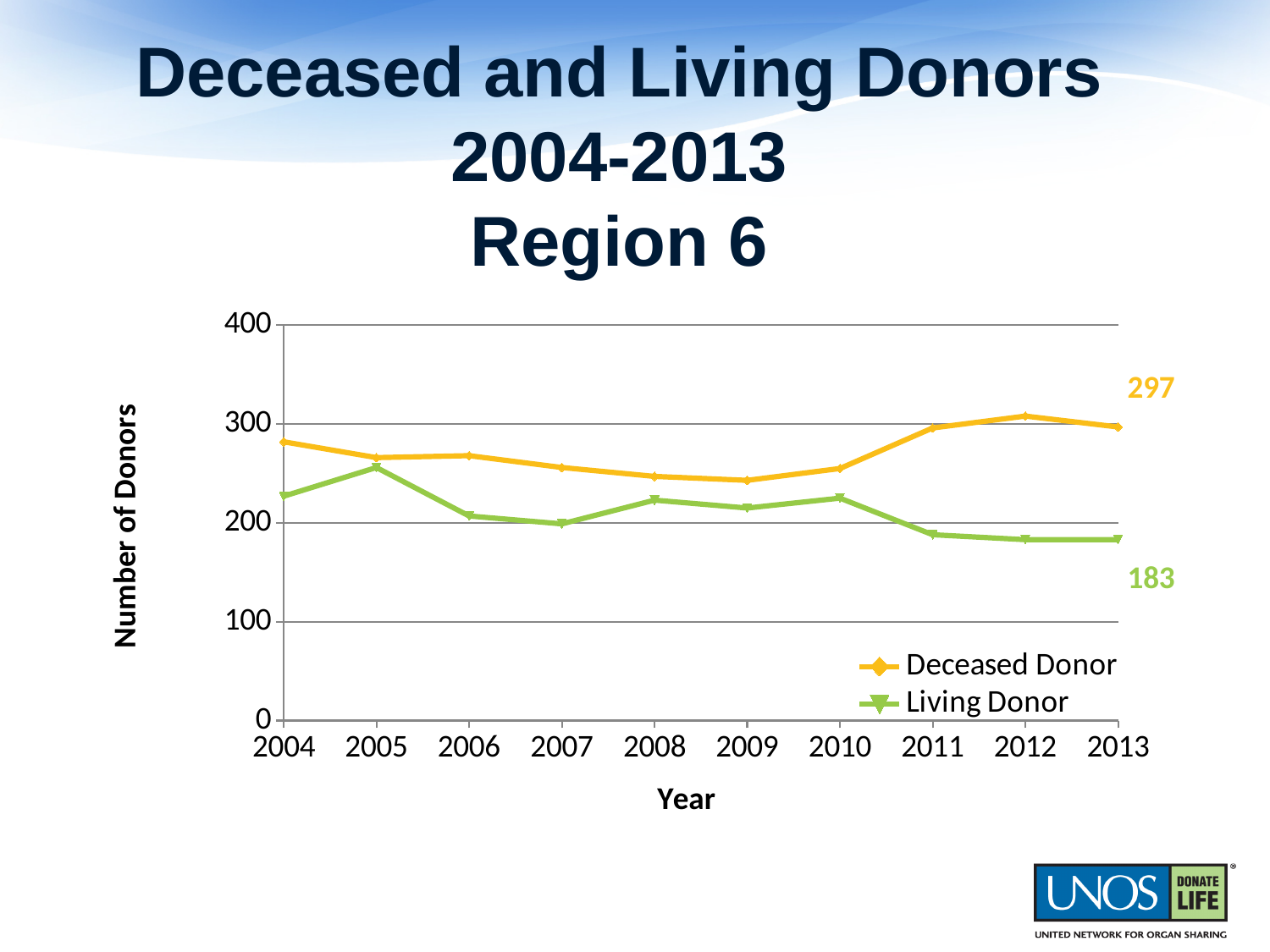
What kind of chart is shown on the slide? Line chart How many years are shown on the x axis? 10 What is the difference between the Deceased Donor and Living Donor values in 2013? 114 Does the Living Donor series rise or fall from 2010 to 2013? Fall Is the Deceased Donor value for 2009 greater or less than 300? less What is the number of Living Donors in 2013? 183 What is the number of Deceased Donors in 2013? 297 In which year is the Living Donor series at its highest? 2005 Is the Deceased Donor value for 2004 greater or less than 200? greater Is the Living Donor value for 2005 greater or less than 200? greater In 2013, which series has the larger value, Deceased Donor or Living Donor? Deceased Donor How many series does the legend list? 2